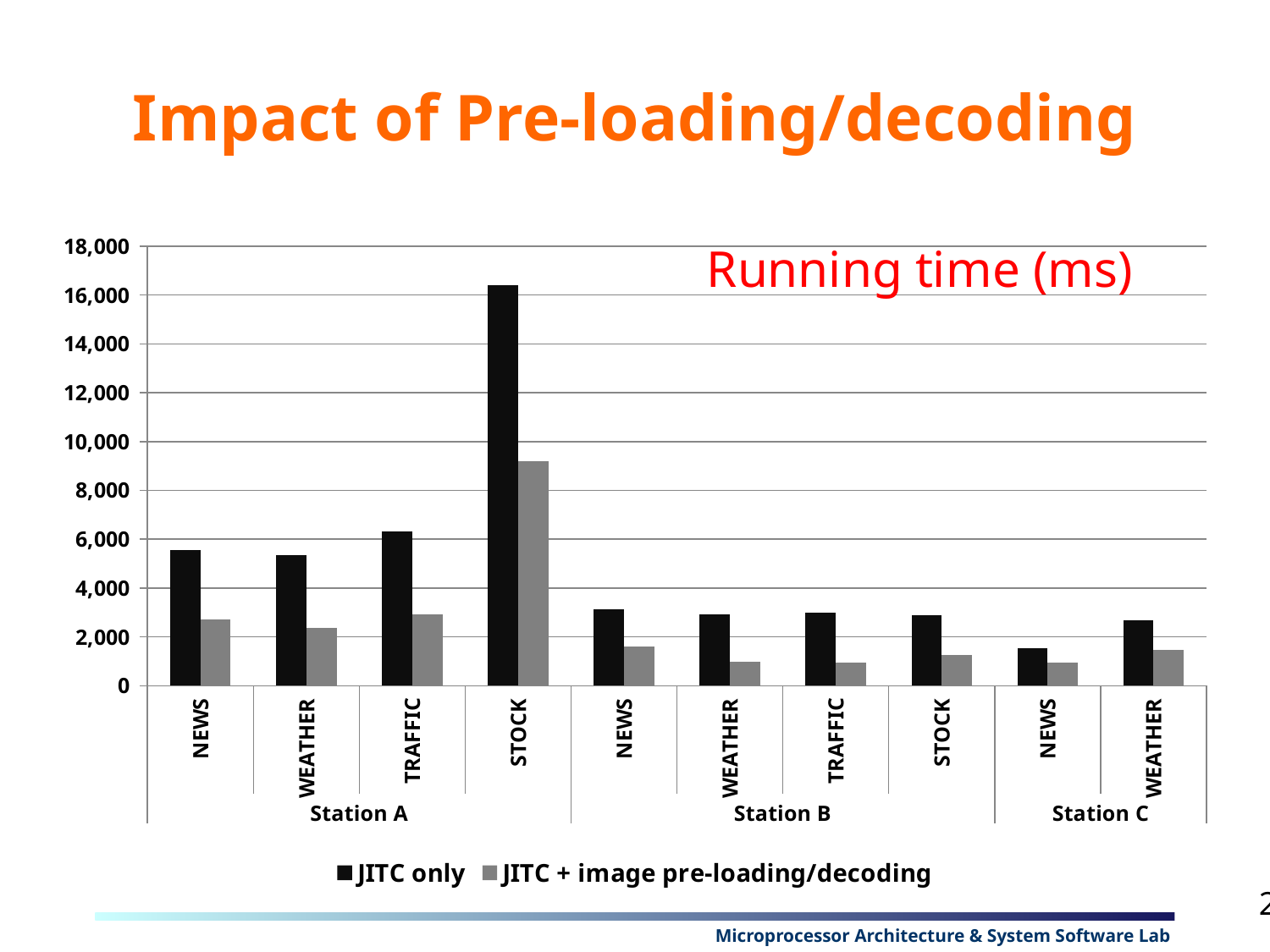
Is the JITC + image pre-loading/decoding value for NEWS in Station B greater or less than 2,000? less How many categories (bar groups) are plotted along the x axis? 10 Which is larger: the JITC only value for NEWS in Station A or the JITC only value for NEWS in Station B? NEWS in Station A Which category has the highest JITC only running time? STOCK (Station A) Which is larger: the JITC + image pre-loading/decoding value for STOCK in Station A or the JITC only value for TRAFFIC in Station A? JITC + image pre-loading/decoding for STOCK in Station A How many series does the legend list? 2 Is the JITC + image pre-loading/decoding value for STOCK in Station A greater or less than 8,000? greater Which category has the lowest JITC only running time? NEWS (Station C) Is the JITC only value for NEWS in Station A greater or less than 6,000? less What unit is the running time measured in, according to the label on the chart? ms What kind of chart is shown on the slide? bar chart